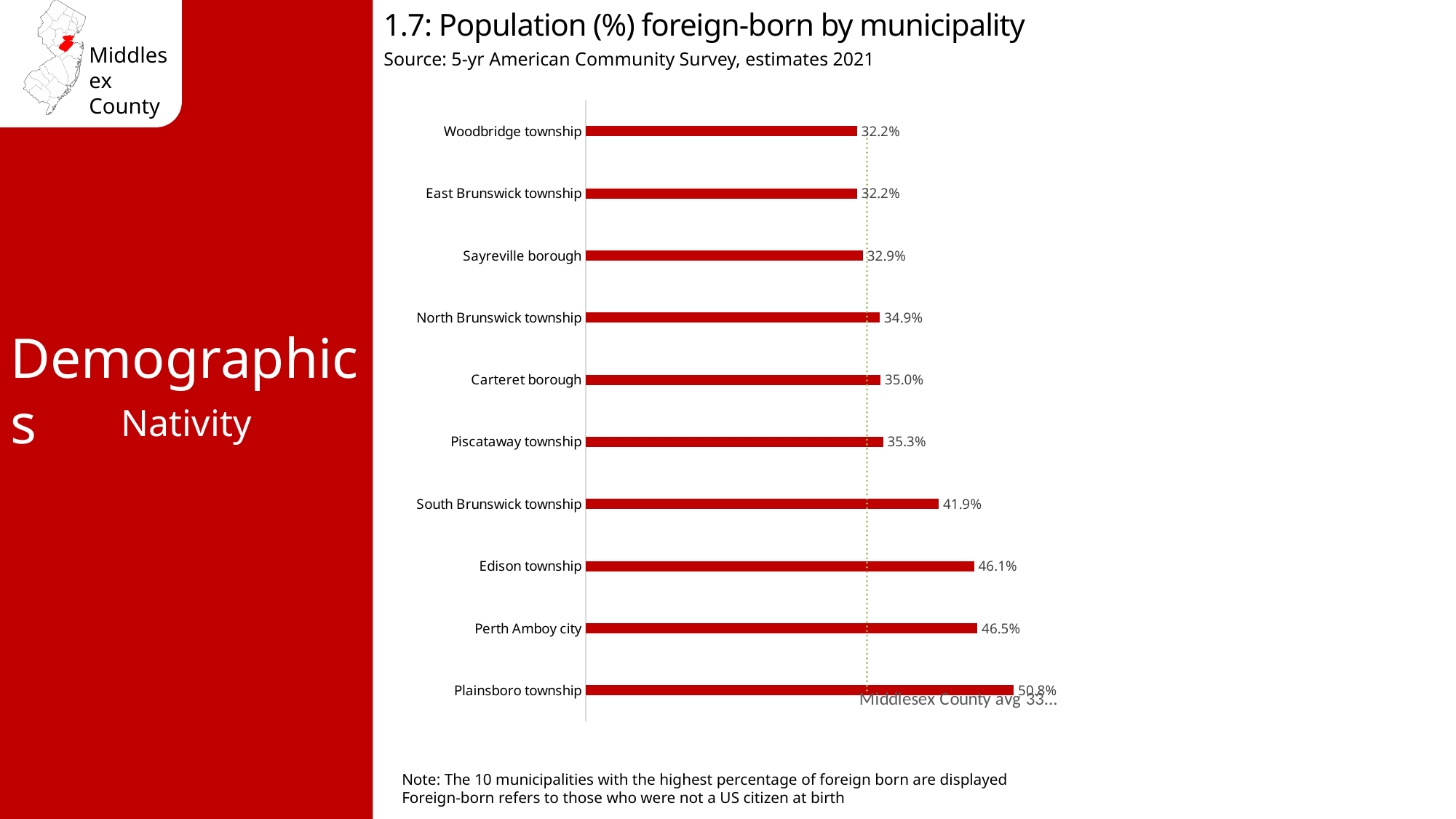
What is the title of the chart? 1.7: Population (%) foreign-born by municipality What is the foreign-born population percentage for Edison township? 46.1% What is the difference in foreign-born percentage between Edison township and South Brunswick township? 4.2 percentage points How many municipalities are shown in the chart? 10 Which has a higher foreign-born percentage, Perth Amboy city or Edison township? Perth Amboy city What is the foreign-born population percentage for Plainsboro township? 50.8% What kind of chart is shown on the slide? Bar chart What is the difference in foreign-born percentage between Plainsboro township and Perth Amboy city? 4.3 percentage points What is the foreign-born population percentage for Sayreville borough? 32.9% What is the foreign-born population percentage for Carteret borough? 35.0% Which municipality has the highest percentage of foreign-born population? Plainsboro township Which has a higher foreign-born percentage, South Brunswick township or Piscataway township? South Brunswick township